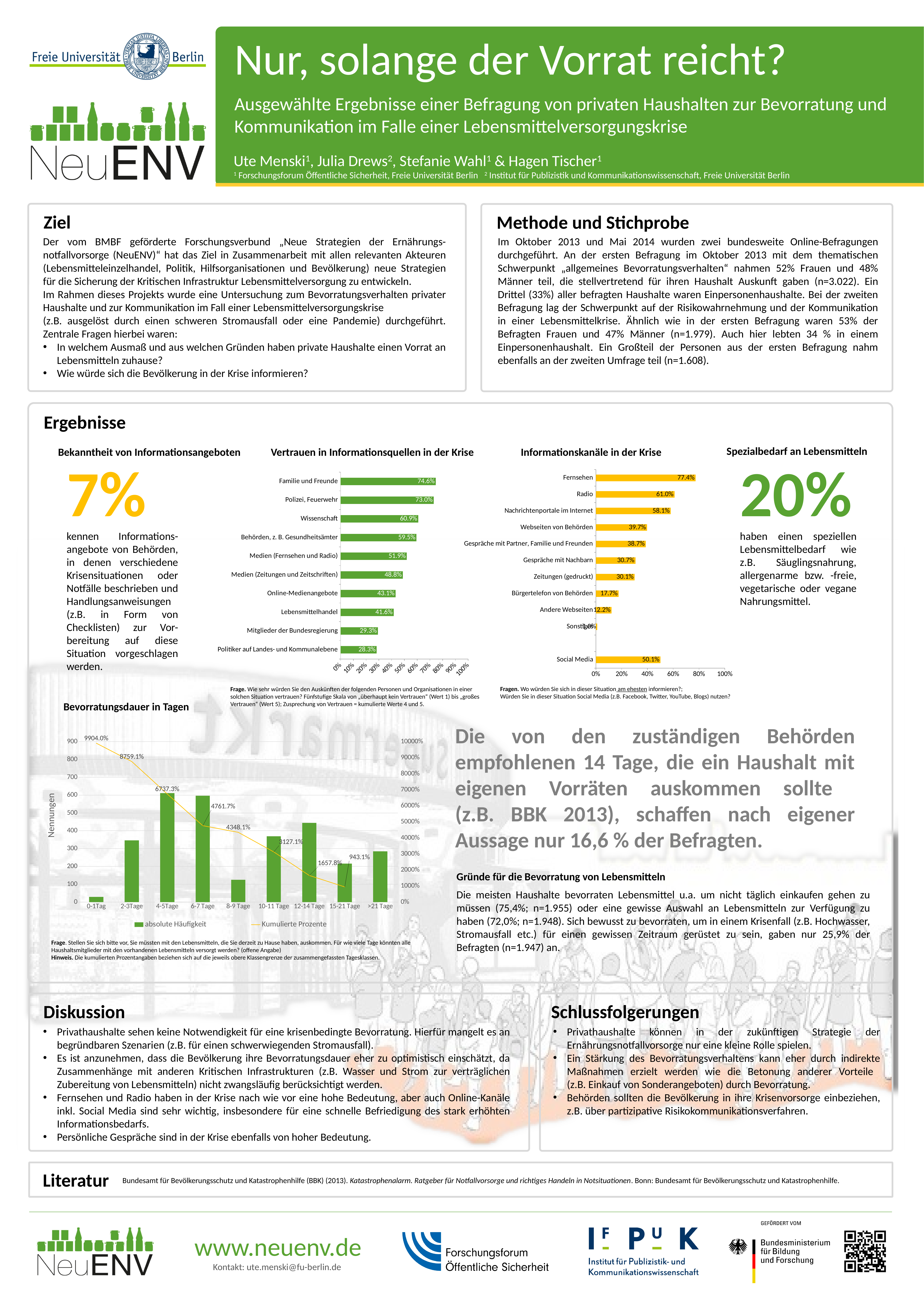
In the chart 'Vertrauen in Informationsquellen in der Krise', what is the difference between Wissenschaft and Lebensmittelhandel? 19.3% How many categories are shown in the chart 'Vertrauen in Informationsquellen in der Krise'? 10 How many day categories are shown on the x axis of the chart 'Bevorratungsdauer in Tagen'? 9 In the chart 'Vertrauen in Informationsquellen in der Krise', which category has the lowest value? Politiker auf Landes- und Kommunalebene In the chart 'Vertrauen in Informationsquellen in der Krise', what is the value for Familie und Freunde? 74.6% In the chart 'Informationskanäle in der Krise', what is the value for Radio? 61.0% What kind of chart is 'Informationskanäle in der Krise'? Bar chart How many series does the legend of the chart 'Bevorratungsdauer in Tagen' list? 2 In the chart 'Informationskanäle in der Krise', which category has the highest value? Fernsehen In the chart 'Bevorratungsdauer in Tagen', is the absolute Häufigkeit for 8-9 Tage greater or less than 200? less In the chart 'Informationskanäle in der Krise', which is larger: Social Media or Webseiten von Behörden? Social Media In the chart 'Informationskanäle in der Krise', what is the difference between Fernsehen and Nachrichtenportale im Internet? 19.3%